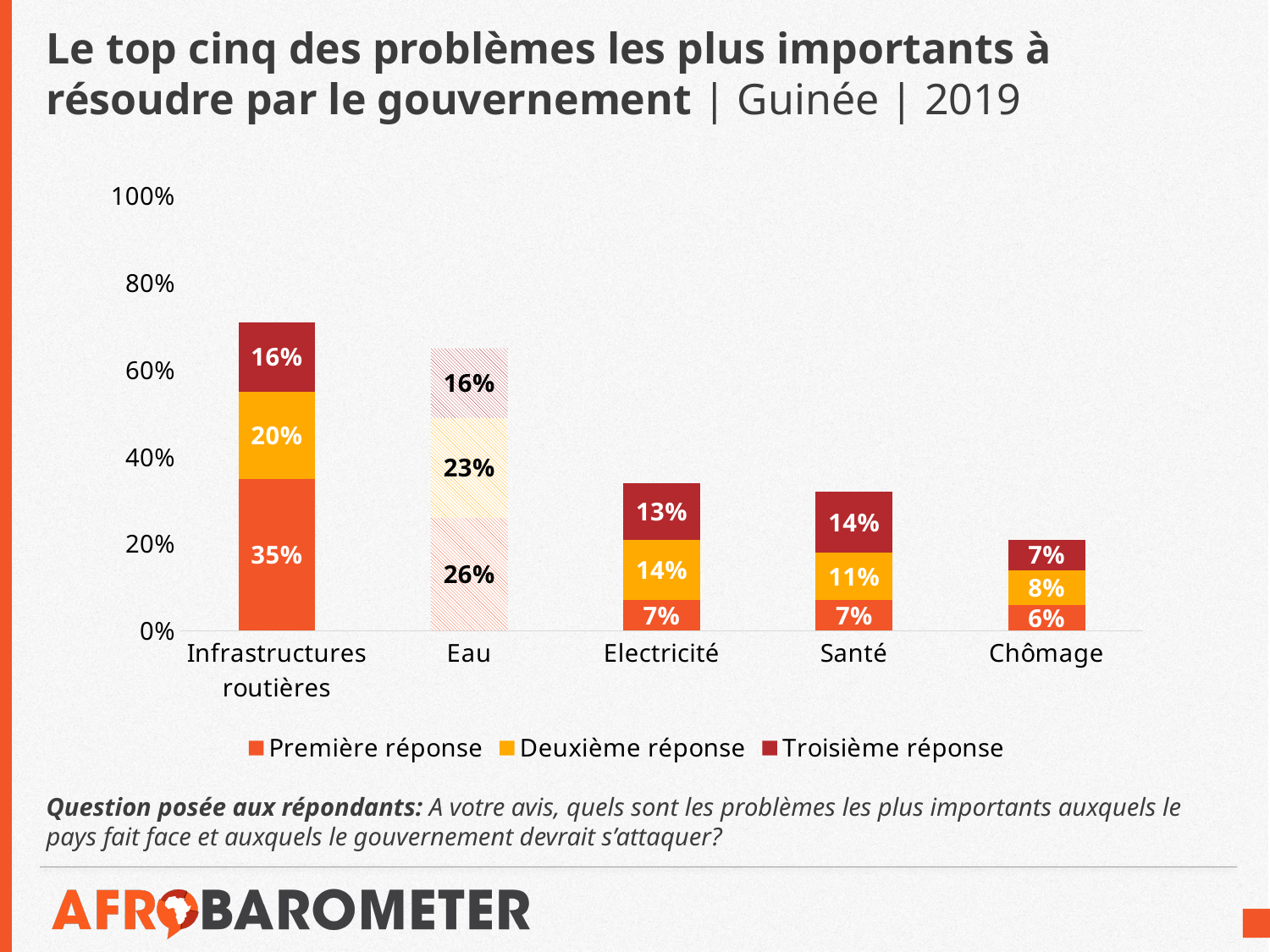
What kind of chart is shown on the slide? Stacked bar chart What is the difference between the 'Première réponse' values for Infrastructures routières and Eau? 9% How many categories are shown on the x axis? 5 What is the 'Deuxième réponse' value for Eau? 23% What is the 'Troisième réponse' value for Santé? 14% Which is larger: the 'Deuxième réponse' value for Electricité or for Santé? Electricité Which category has the lowest 'Deuxième réponse' value? Chômage What is the total of the stacked bar for Chômage? 21% Which category has the highest 'Première réponse' value? Infrastructures routières What is the 'Première réponse' value for Chômage? 6% What is the 'Première réponse' value for Infrastructures routières? 35% How many series does the legend list? 3